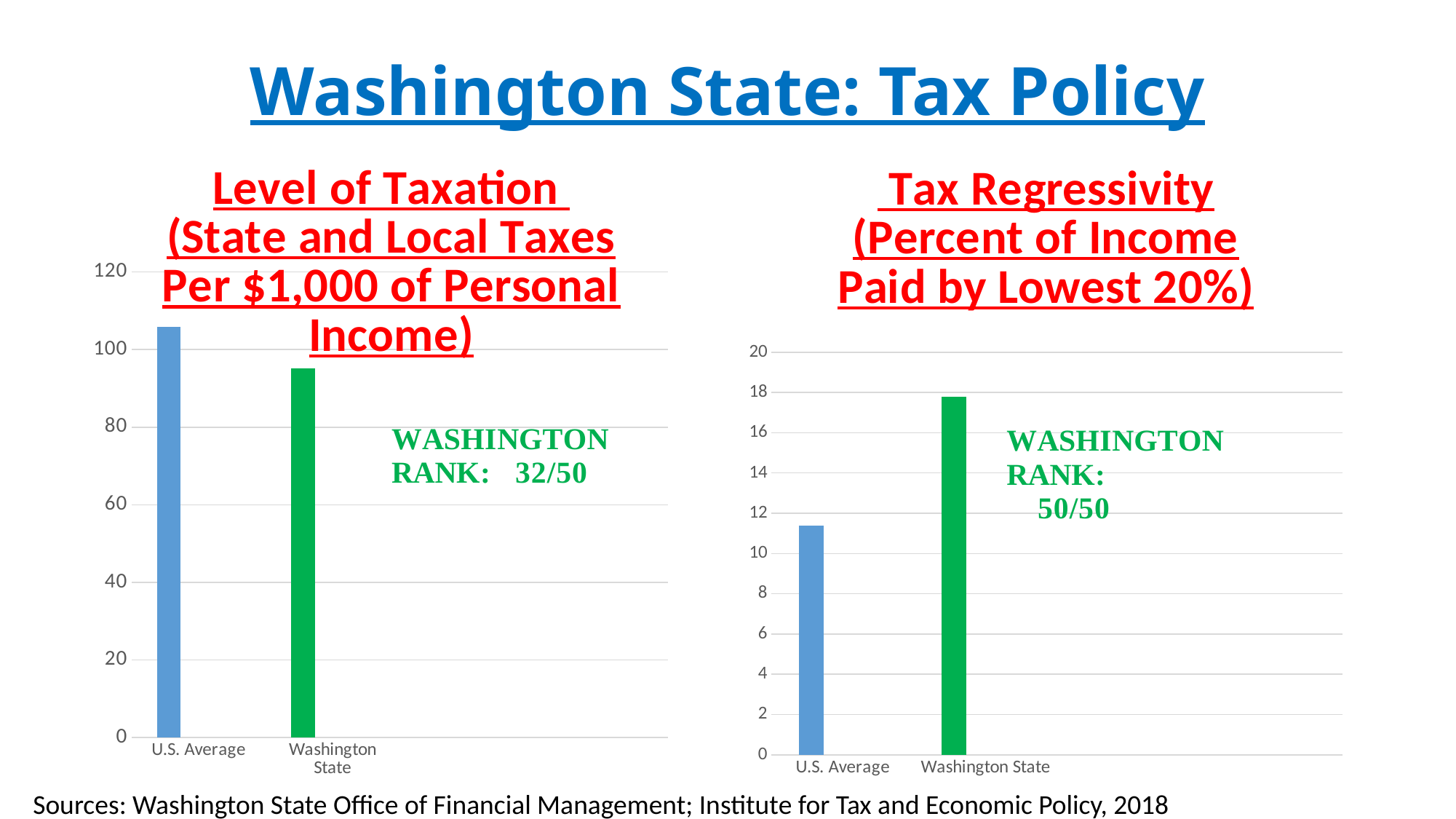
How many bars are plotted in the 'Tax Regressivity' chart on the right? 2 In the 'Level of Taxation' chart on the left, which category has the higher bar? U.S. Average In the 'Level of Taxation' chart on the left, is the value for U.S. Average greater or less than 100? greater In the 'Tax Regressivity' chart on the right, is the value for U.S. Average greater or less than 12? less In the 'Level of Taxation' chart on the left, is the value for Washington State greater or less than 100? less What Washington rank is printed on the 'Level of Taxation' chart on the left? 32/50 What is the highest tick value shown on the y axis of the 'Tax Regressivity' chart on the right? 20 In the 'Tax Regressivity' chart on the right, which category has the lower bar? U.S. Average In the 'Tax Regressivity' chart on the right, is the bar for Washington State larger or smaller than the bar for U.S. Average? larger What kind of chart is the 'Level of Taxation' chart on the left? bar chart